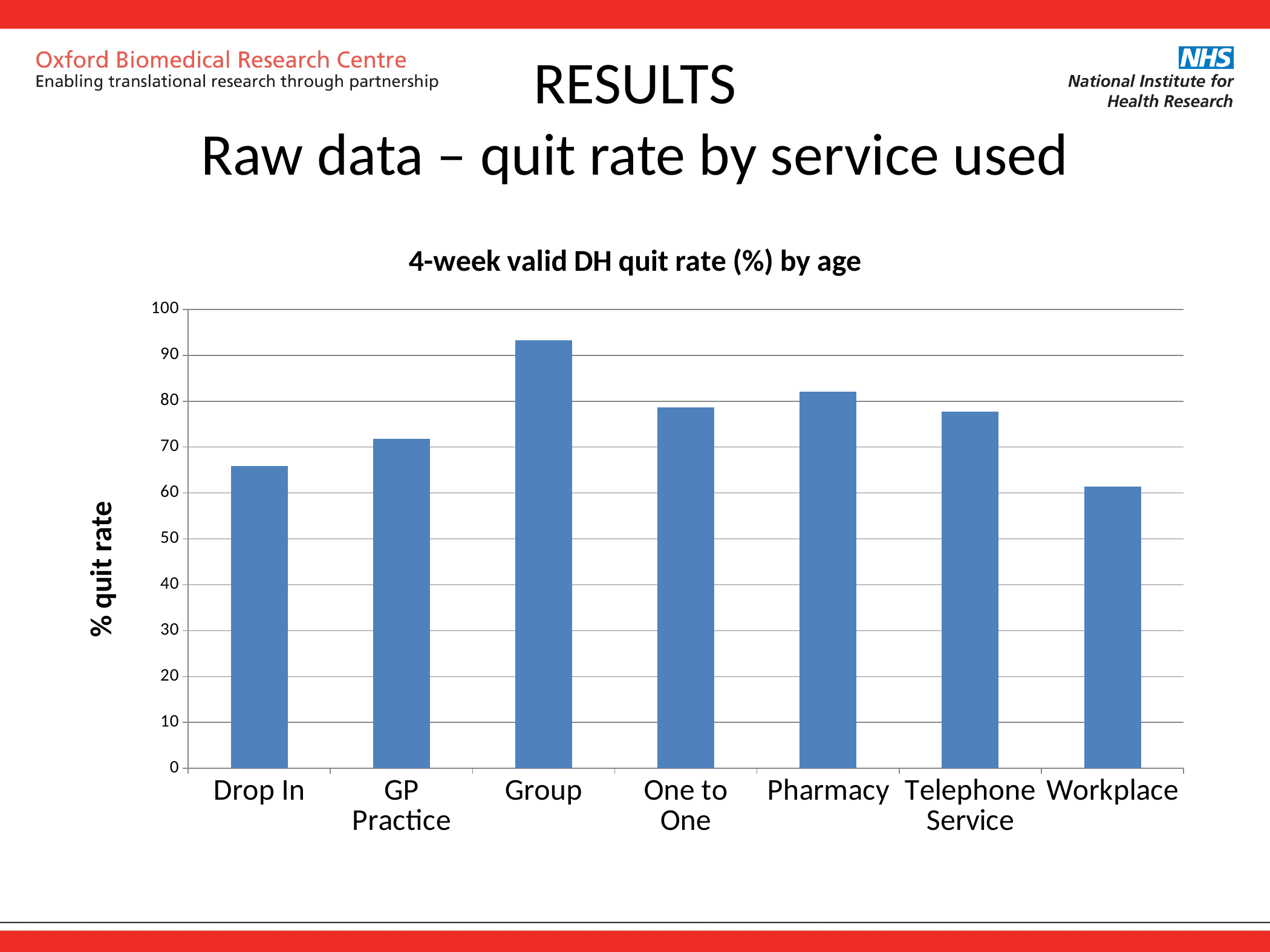
Which service has the highest quit rate in the chart? Group What kind of chart is shown on the slide? bar chart Is the quit rate for Telephone Service greater or less than 80? less Is the quit rate for Workplace greater or less than 60? greater What is the label on the vertical axis of the chart? % quit rate Which has a higher quit rate, GP Practice or Drop In? GP Practice How many services (categories) are shown on the x axis of the chart? 7 Which has a higher quit rate, Group or Pharmacy? Group Is the quit rate for Drop In greater or less than 70? less Which service has the lowest quit rate in the chart? Workplace